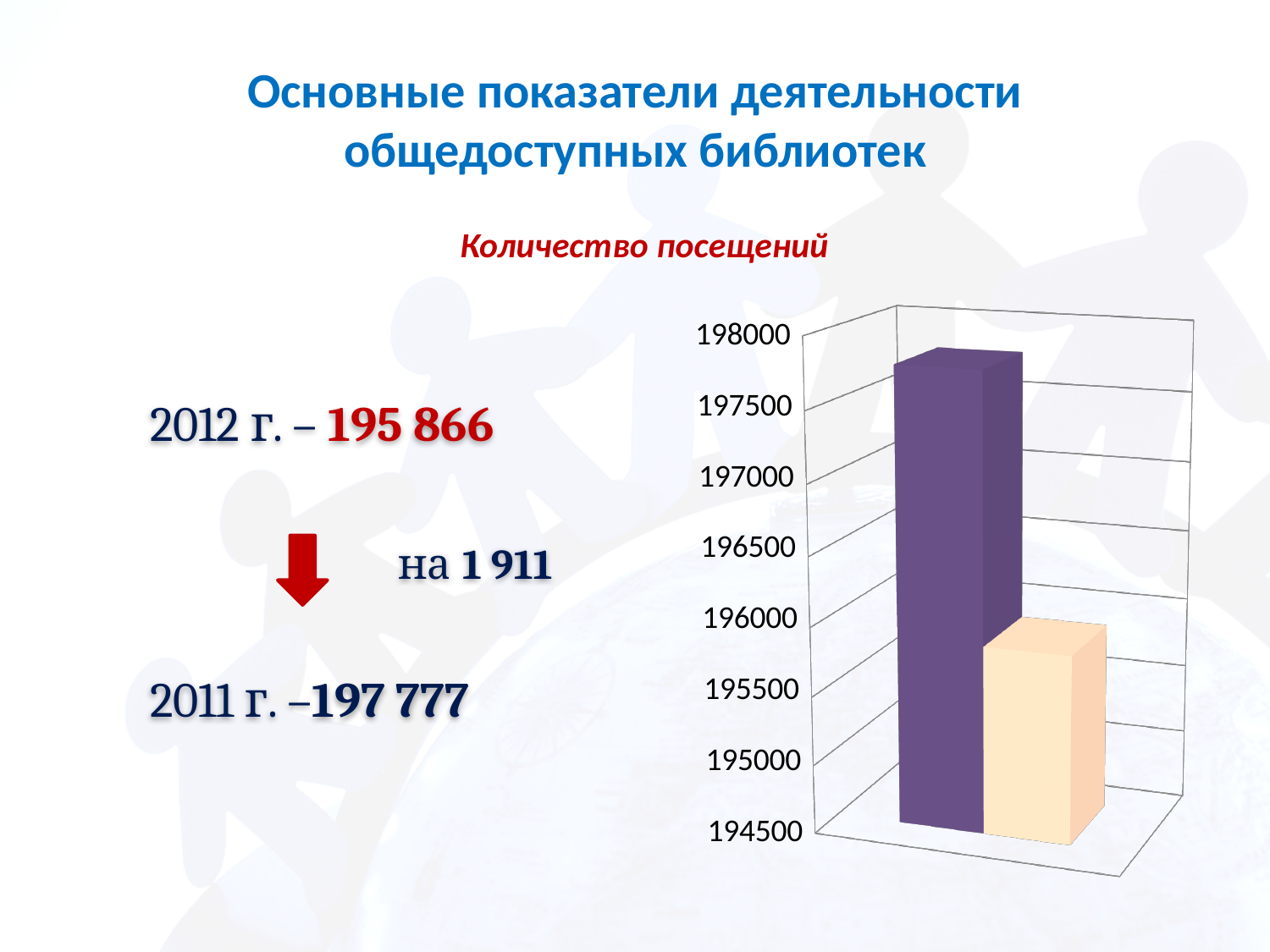
Is the value of the purple bar greater or less than 197500? greater What kind of chart is shown on the slide? bar chart What is the title shown above the chart? Количество посещений Is the value of the beige bar greater or less than 196000? less Which bar is taller in the chart, the purple one or the beige one? the purple one What is the lowest tick label on the vertical axis of the chart? 194500 How many tick labels are shown on the vertical axis of the chart? 8 How many bars are plotted in the chart? 2 According to the slide, what was the number of visits in 2012? 195 866 Is the value of the purple bar greater or less than 198000? less According to the slide, what was the number of visits in 2011? 197 777